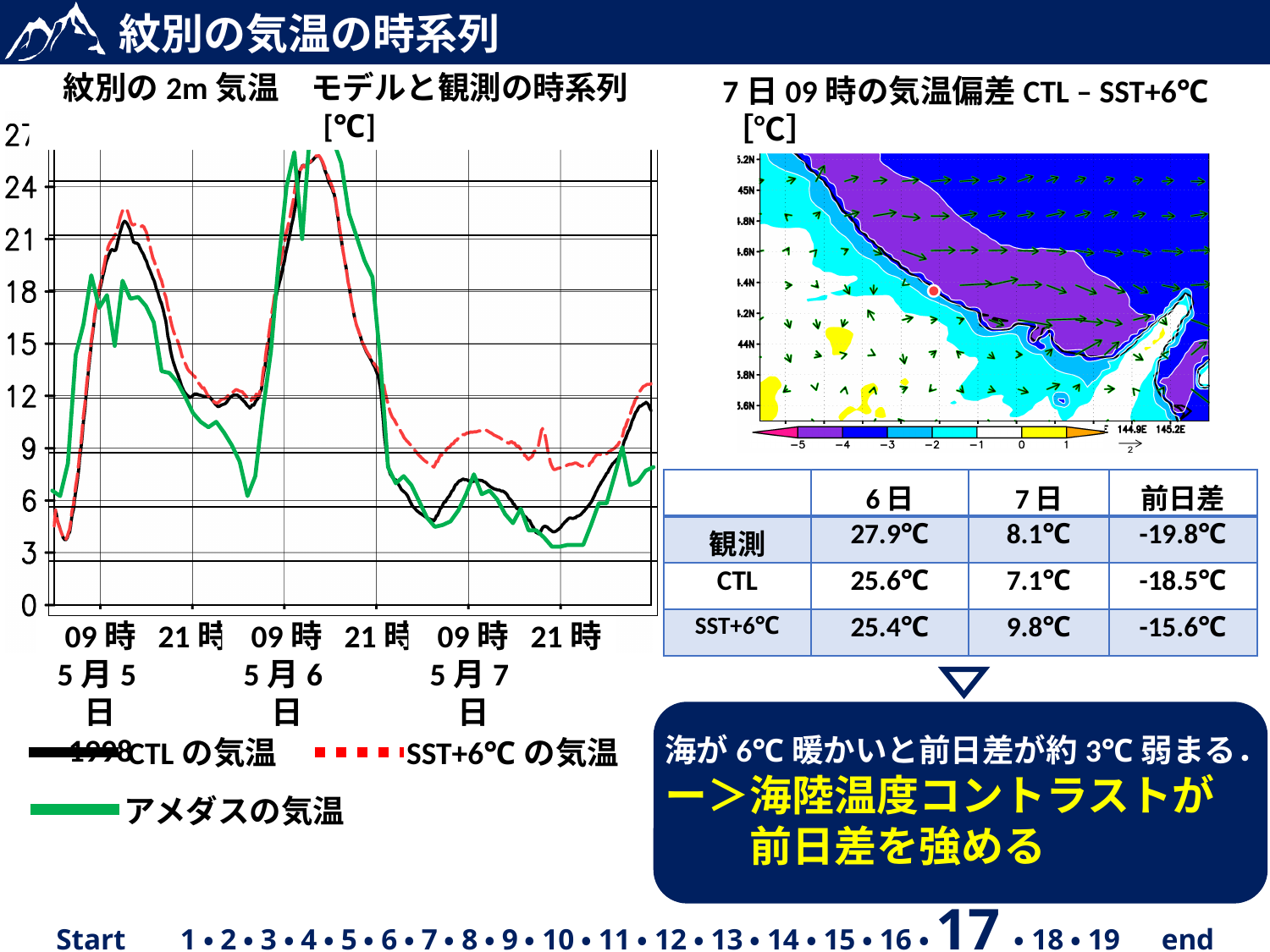
In the left chart, which colour is used for the アメダスの気温 series? green In the left chart, does the CTL の気温 series rise or fall between 09時 and 21時 on 5月6日? fall In the left chart, is the peak value of the CTL の気温 series around 09時 on 5月6日 greater or less than 24? greater In the left chart, is the lowest value of the アメダスの気温 series around 21時 on 5月7日 greater or less than 6? less In the left chart, is the value of the SST+6℃ の気温 series at 09時 on 5月7日 greater or less than 6? greater What is the title of the left chart? 紋別の 2m 気温 モデルと観測の時系列 [℃] In the left chart, which series has the highest value at 09時 on 5月7日? SST+6℃ の気温 In the left chart, at 09時 on 5月7日, which is larger: the CTL の気温 value or the SST+6℃ の気温 value? SST+6℃ の気温 In the left chart, does the CTL の気温 series rise or fall between 21時 on 5月5日 and 09時 on 5月6日? rise What kind of chart is the chart on the left of the slide? line chart How many series does the legend of the left chart list? 3